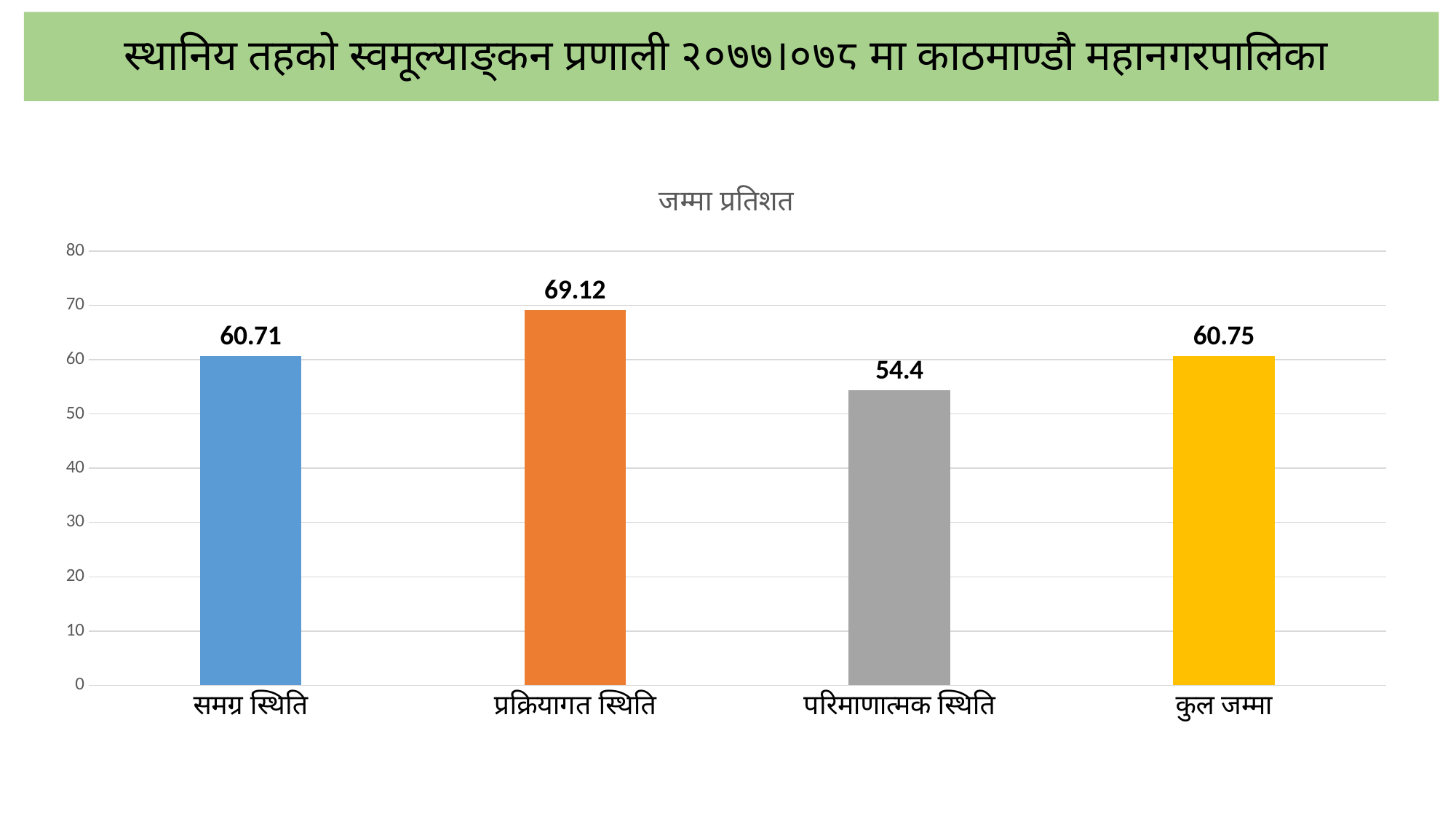
Which category has the lowest value? परिमाणात्मक स्थिति How many categories are shown in the chart? 4 What is the difference between the values for प्रक्रियागत स्थिति and समग्र स्थिति? 8.41 Which is larger, the value for समग्र स्थिति or the value for परिमाणात्मक स्थिति? समग्र स्थिति What is the value for कुल जम्मा? 60.75 What is the value for परिमाणात्मक स्थिति? 54.4 What is the value for प्रक्रियागत स्थिति? 69.12 What is the difference between the values for प्रक्रियागत स्थिति and परिमाणात्मक स्थिति? 14.72 What is the value for समग्र स्थिति? 60.71 Which category has the highest value? प्रक्रियागत स्थिति Is the value for परिमाणात्मक स्थिति greater or less than 60? less What kind of chart is shown on the slide? bar chart